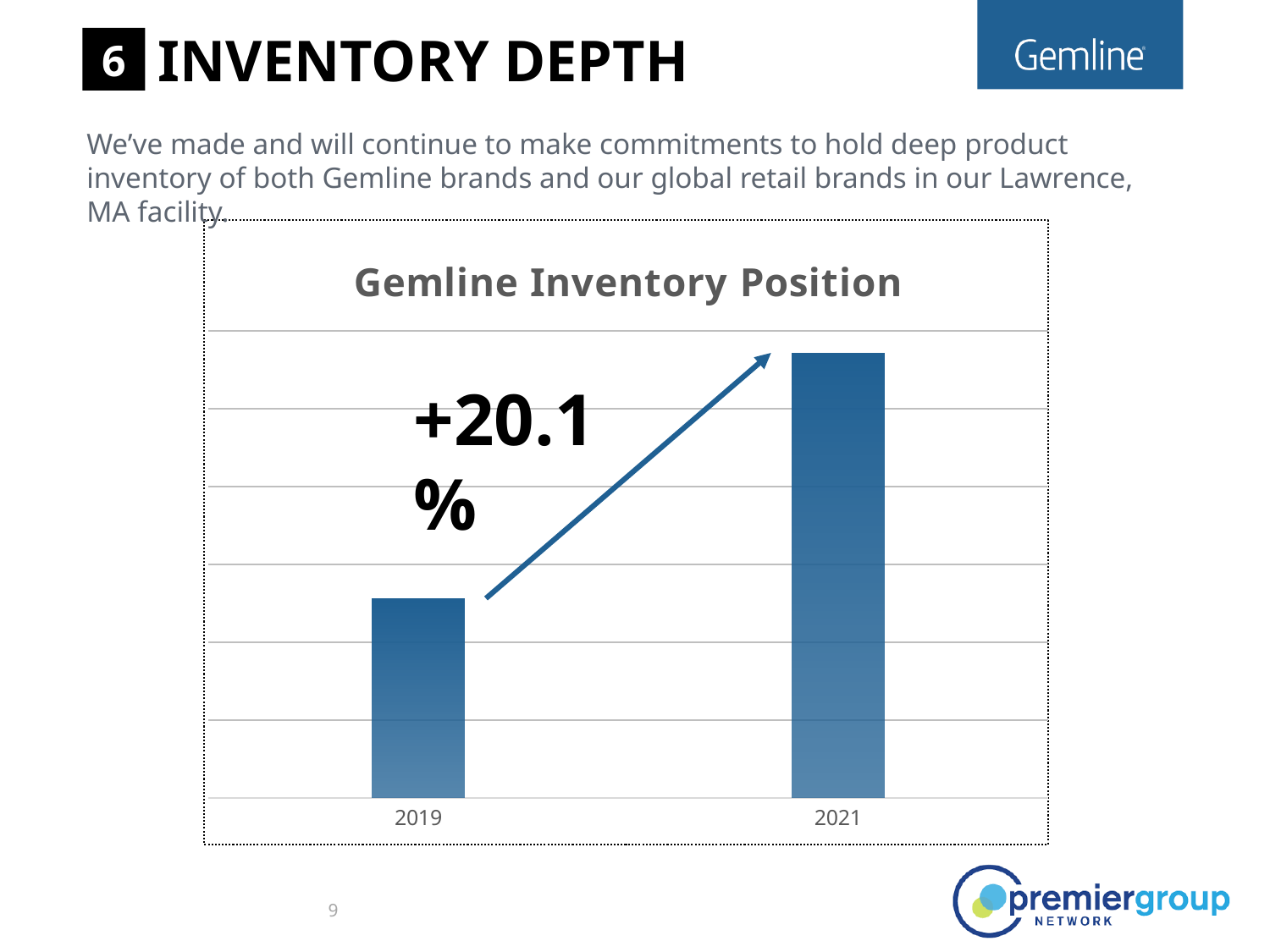
Which bar is taller, 2019 or 2021? 2021 Do the values rise or fall from 2019 to 2021? rise What is the title of the chart? Gemline Inventory Position Which year has the lowest bar in the chart? 2019 How many categories are plotted on the x axis of the chart? 2 What kind of chart is shown on the slide? bar chart What percentage change is annotated on the chart between 2019 and 2021? +20.1% What are the two years shown on the x axis of the chart? 2019 and 2021 Which year has the highest bar in the chart? 2021